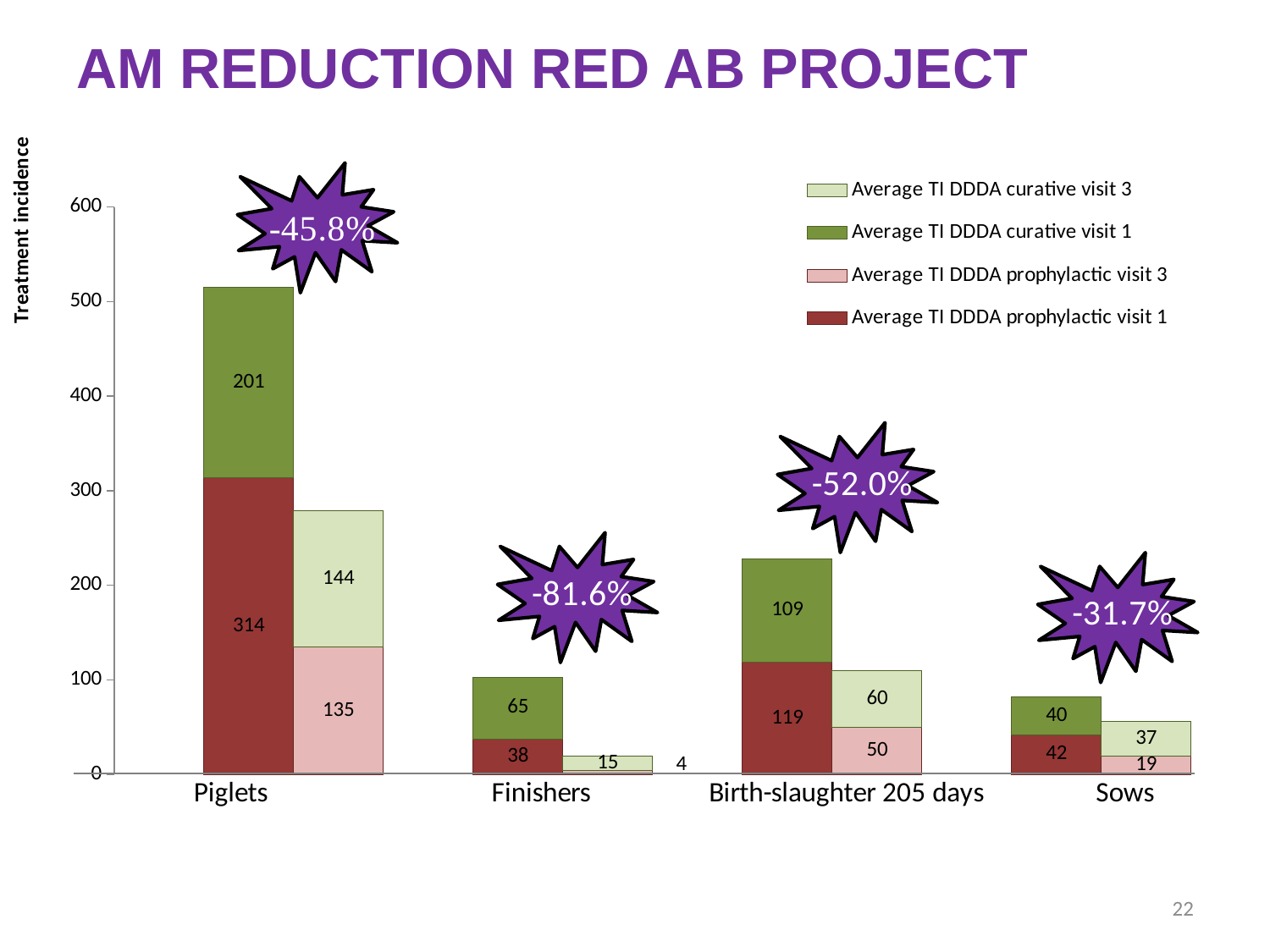
What is the Average TI DDDA curative visit 3 value for Birth-slaughter 205 days? 60 What percentage reduction is shown in the starburst above the Finishers bars? -81.6% Which category has the highest Average TI DDDA curative visit 1 value? Piglets What is the total of the visit 3 stacked bar (prophylactic plus curative) for Birth-slaughter 205 days? 110 What is the Average TI DDDA prophylactic visit 3 value for Finishers? 4 How many series does the legend list? 4 What is the Average TI DDDA prophylactic visit 1 value for Piglets? 314 Which category has the lowest Average TI DDDA prophylactic visit 3 value? Finishers Is the Average TI DDDA prophylactic visit 1 value for Sows larger or smaller than the curative visit 1 value for Sows? larger What is the difference between the Average TI DDDA curative visit 1 and curative visit 3 values for Finishers? 50 What is the Average TI DDDA curative visit 1 value for Sows? 40 What is the total of the visit 1 stacked bar (prophylactic plus curative) for Piglets? 515